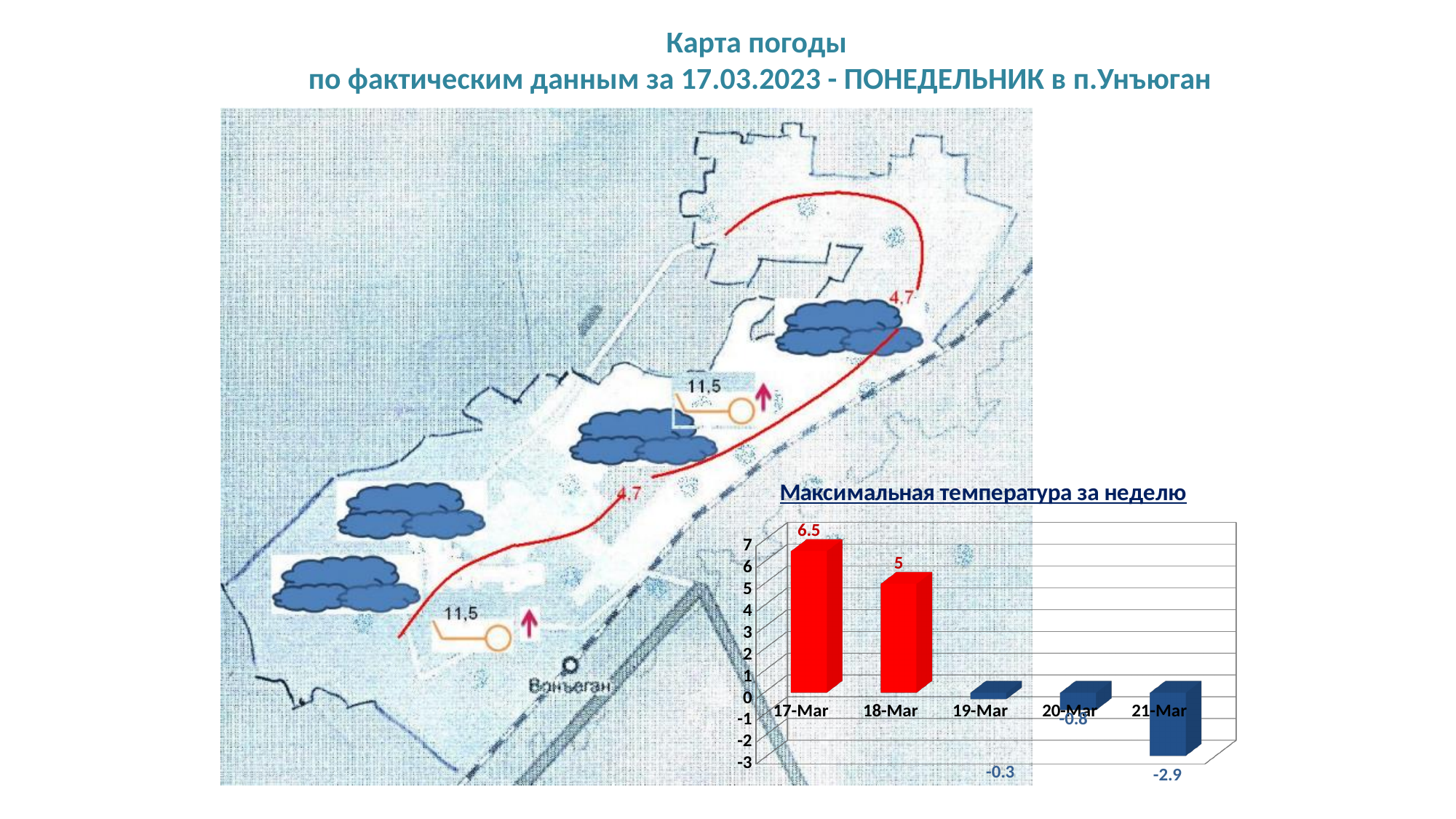
Do the values rise or fall from 17-Mar to 21-Mar? fall What is the difference between the values for 17-Mar and 18-Mar? 1.5 Which date has the highest maximum temperature? 17-Mar Which date has the lowest maximum temperature? 21-Mar What is the value for 18-Mar? 5 What is the value for 17-Mar? 6.5 How many dates are shown on the x axis of the chart? 5 What kind of chart is shown on the slide? bar chart What is the title of the chart on the slide? Максимальная температура за неделю What is the value for 21-Mar? -2.9 What is the value for 19-Mar? -0.3 Which is larger, the value for 19-Mar or the value for 21-Mar? 19-Mar